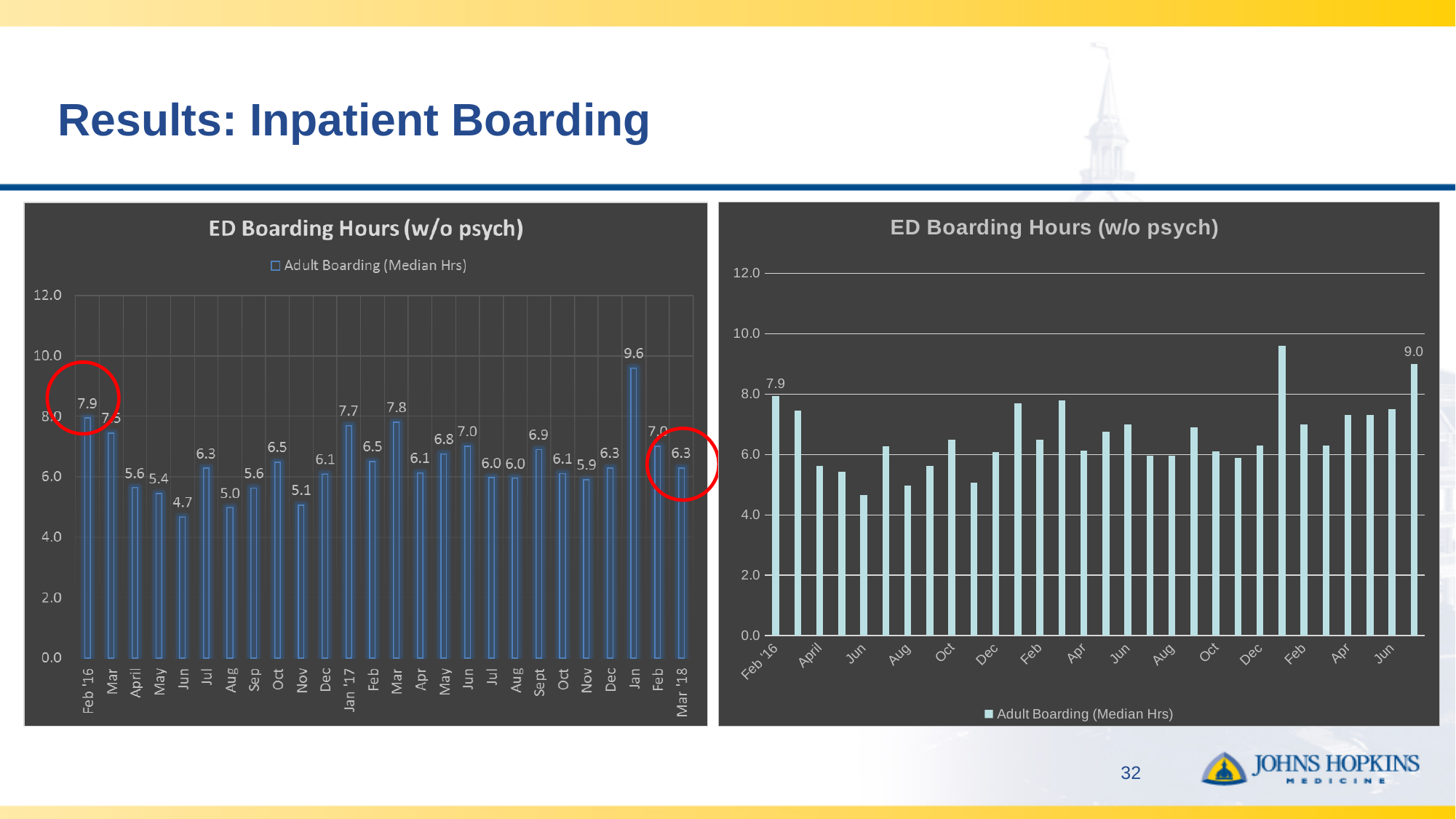
How many series does the legend of the right chart list? 1 On the left chart, what is the value for Mar '18? 6.3 On the right chart, is the value for Jun 2016 greater or less than 6.0? less On the left chart, which month has the lowest median boarding hours? Jun (2016), 4.7 On the left chart, which is larger: the value for Oct 2016 or the value for Nov 2016? Oct 2016 (6.5) What kind of chart is the left chart? Bar chart What is the legend entry shown on the left chart? Adult Boarding (Median Hrs) On the right chart, what is the value labelled for Feb '16? 7.9 On the left chart, which month has the highest median boarding hours? Jan (2018), 9.6 On the left chart, what is the difference between the Jan 2018 value (9.6) and the Feb '16 value (7.9)? 1.7 On the left chart, what is the Adult Boarding (Median Hrs) value for Jun 2016? 4.7 On the right chart, what is the value labelled on the last bar? 9.0